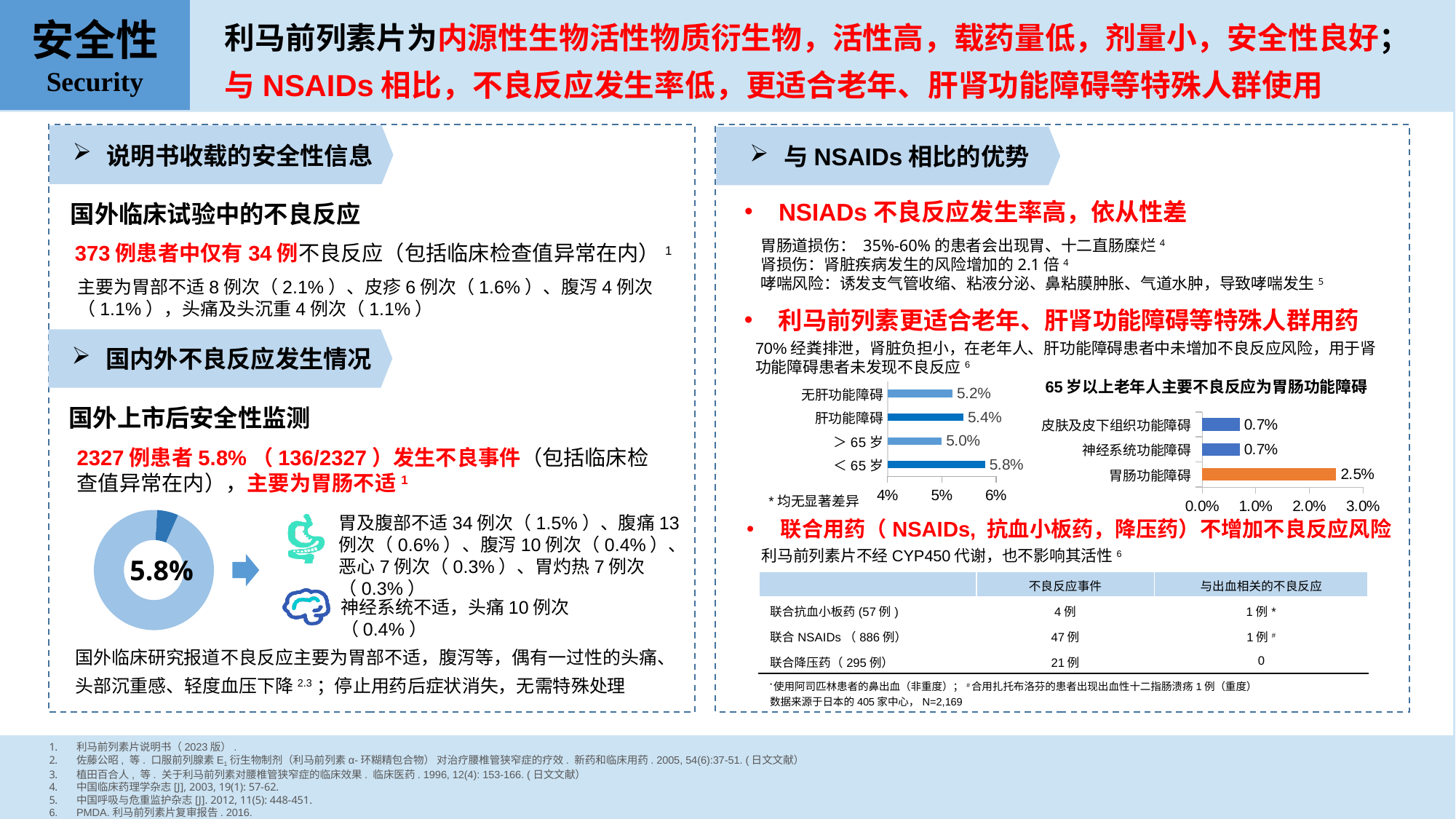
In the bar chart on the right side of the slide with categories 无肝功能障碍, 肝功能障碍, ＞65 岁 and ＜65 岁, what is the value for 肝功能障碍? 5.4% In the chart titled '65 岁以上老年人主要不良反应为胃肠功能障碍', what is the value for 胃肠功能障碍? 2.5% In the bar chart on the right side of the slide with categories 无肝功能障碍, 肝功能障碍, ＞65 岁 and ＜65 岁, which category has the lowest value? ＞65 岁 In the bar chart on the right side of the slide with categories 无肝功能障碍, 肝功能障碍, ＞65 岁 and ＜65 岁, which category has the highest value? ＜65 岁 In the chart titled '65 岁以上老年人主要不良反应为胃肠功能障碍', which category has the highest value? 胃肠功能障碍 In the bar chart on the right side of the slide with categories 无肝功能障碍, 肝功能障碍, ＞65 岁 and ＜65 岁, what is the difference between the values for ＜65 岁 and 无肝功能障碍? 0.6% In the chart titled '65 岁以上老年人主要不良反应为胃肠功能障碍', what is the value for 神经系统功能障碍? 0.7% In the chart titled '65 岁以上老年人主要不良反应为胃肠功能障碍', what is the difference between the values for 胃肠功能障碍 and 皮肤及皮下组织功能障碍? 1.8% What kind of chart is the one titled '65 岁以上老年人主要不良反应为胃肠功能障碍'? Bar chart What value is shown in the centre of the donut chart on the left side of the slide? 5.8% In the bar chart on the right side of the slide with categories 无肝功能障碍, 肝功能障碍, ＞65 岁 and ＜65 岁, what is the value for ＞65 岁? 5.0% In the bar chart on the right side of the slide with categories 无肝功能障碍, 肝功能障碍, ＞65 岁 and ＜65 岁, how many categories are plotted? 4